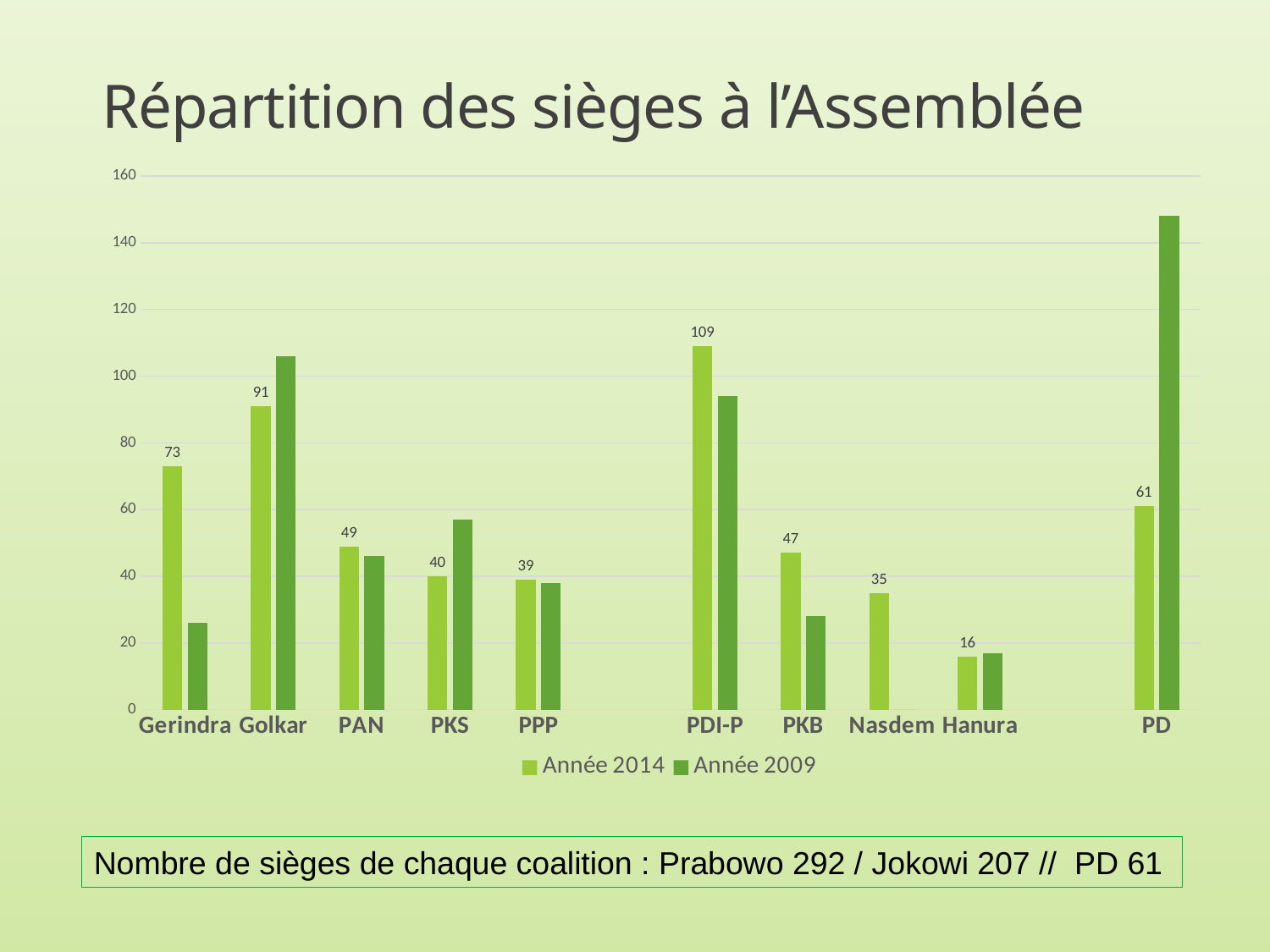
How many series does the legend list? 2 Is the Année 2009 value for PD greater or less than 140? greater What is the Année 2014 value for PDI-P? 109 What type of chart is shown on the slide? bar chart Is the Année 2009 value for Gerindra greater or less than 40? less How many parties are shown on the x axis? 10 Which is larger for Année 2014: PAN or PKB? PAN Which party has the lowest Année 2014 value? Hanura How many seats did Gerindra have in Année 2014? 73 What is the difference between the Année 2014 values for Golkar and Gerindra? 18 What is the Année 2014 value for Nasdem? 35 Which party has the highest Année 2014 value? PDI-P